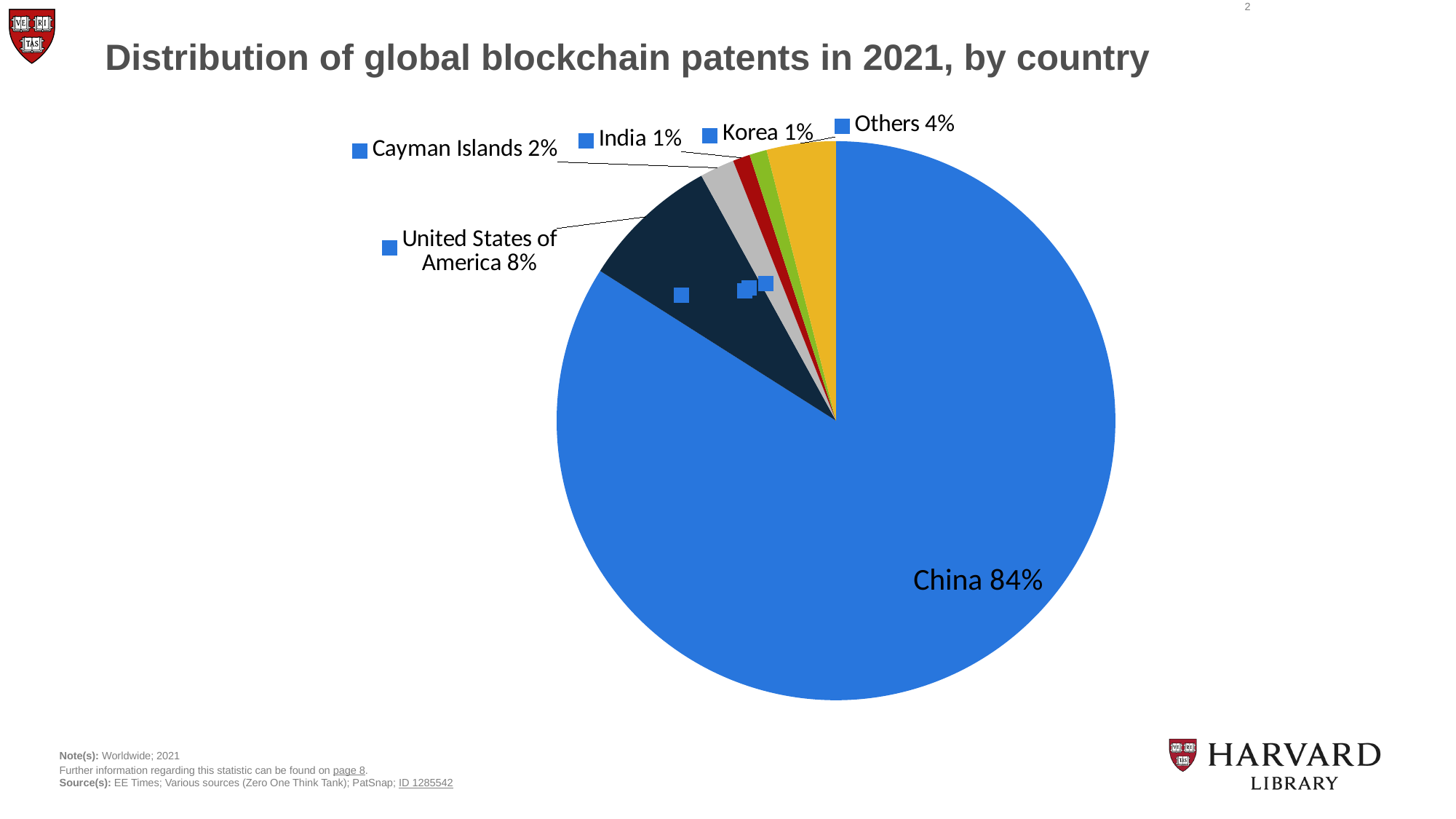
What share of global blockchain patents in 2021 do the Cayman Islands hold? 2% What is the difference in percentage points between China's share and the United States of America's share? 76 Which country has the largest share of global blockchain patents in 2021? China What kind of chart is shown on the slide? Pie chart What share of global blockchain patents in 2021 does India hold? 1% What share of global blockchain patents in 2021 is attributed to Others? 4% What is the combined share of the United States of America and the Cayman Islands? 10% How many slices does the pie chart have? 6 What is the title of the chart? Distribution of global blockchain patents in 2021, by country Which has a larger share of global blockchain patents, the United States of America or the Cayman Islands? United States of America What share of global blockchain patents in 2021 does the United States of America hold? 8% What share of global blockchain patents in 2021 does China hold? 84%